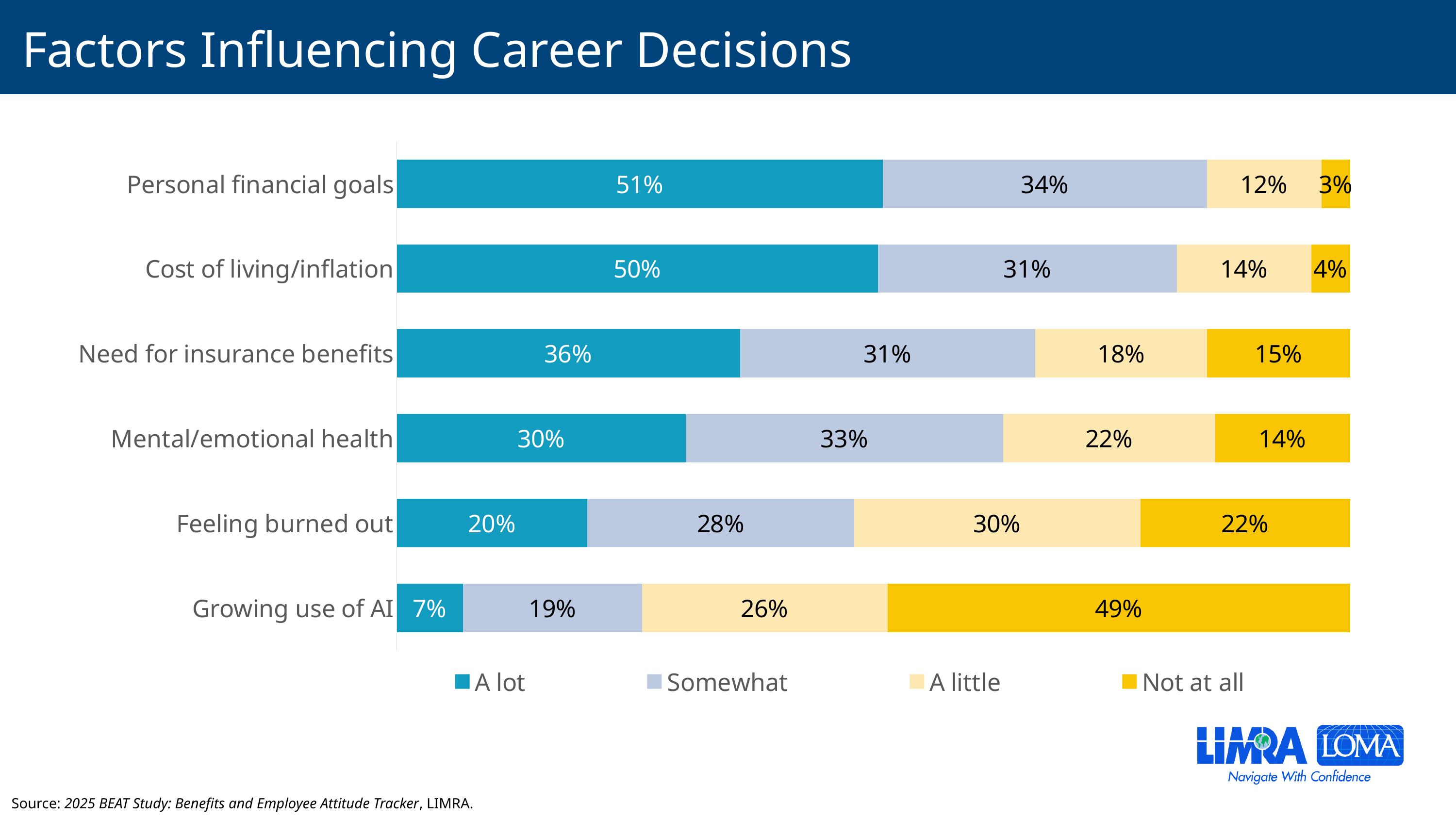
Which factor has the highest 'A lot' value? Personal financial goals What is the 'Not at all' value for Growing use of AI? 49% How many factors are shown in the chart? 6 What percentage of respondents said personal financial goals influence their career decisions 'A lot'? 51% What is the total of the stacked bar for Cost of living/inflation? 99% What is the difference between the 'Not at all' values for Growing use of AI and Feeling burned out? 27% What kind of chart is shown on the slide? Stacked bar chart Which factor has the lowest 'A lot' value? Growing use of AI What is the 'Somewhat' value for Mental/emotional health? 33% What is the 'A little' value for Feeling burned out? 30% Which is larger: the 'A lot' value for Need for insurance benefits or for Mental/emotional health? Need for insurance benefits How many series does the legend list? 4